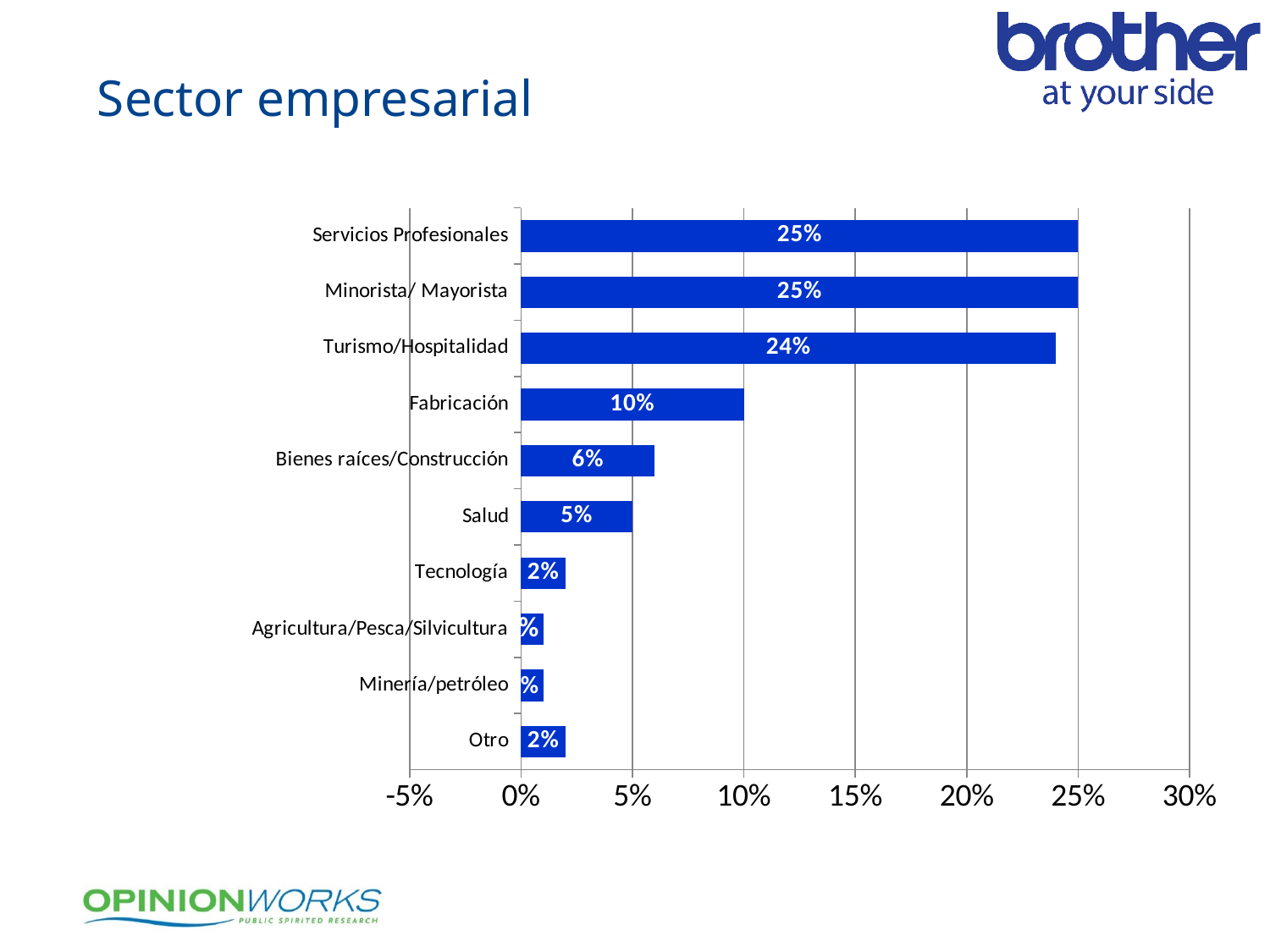
What kind of chart is shown on the slide? bar chart What is the value for Turismo/Hospitalidad? 24% Which is larger, the value for Turismo/Hospitalidad or the value for Fabricación? Turismo/Hospitalidad What is the value for Bienes raíces/Construcción? 6% What is the value for Servicios Profesionales? 25% What is the difference between the values for Fabricación and Salud? 5% How many categories are shown in the chart? 10 What is the value for Salud? 5% What is the value for Otro? 2% What is the value for Fabricación? 10% What is the title of the slide containing the chart? Sector empresarial Is the value for Agricultura/Pesca/Silvicultura greater or less than 5%? less